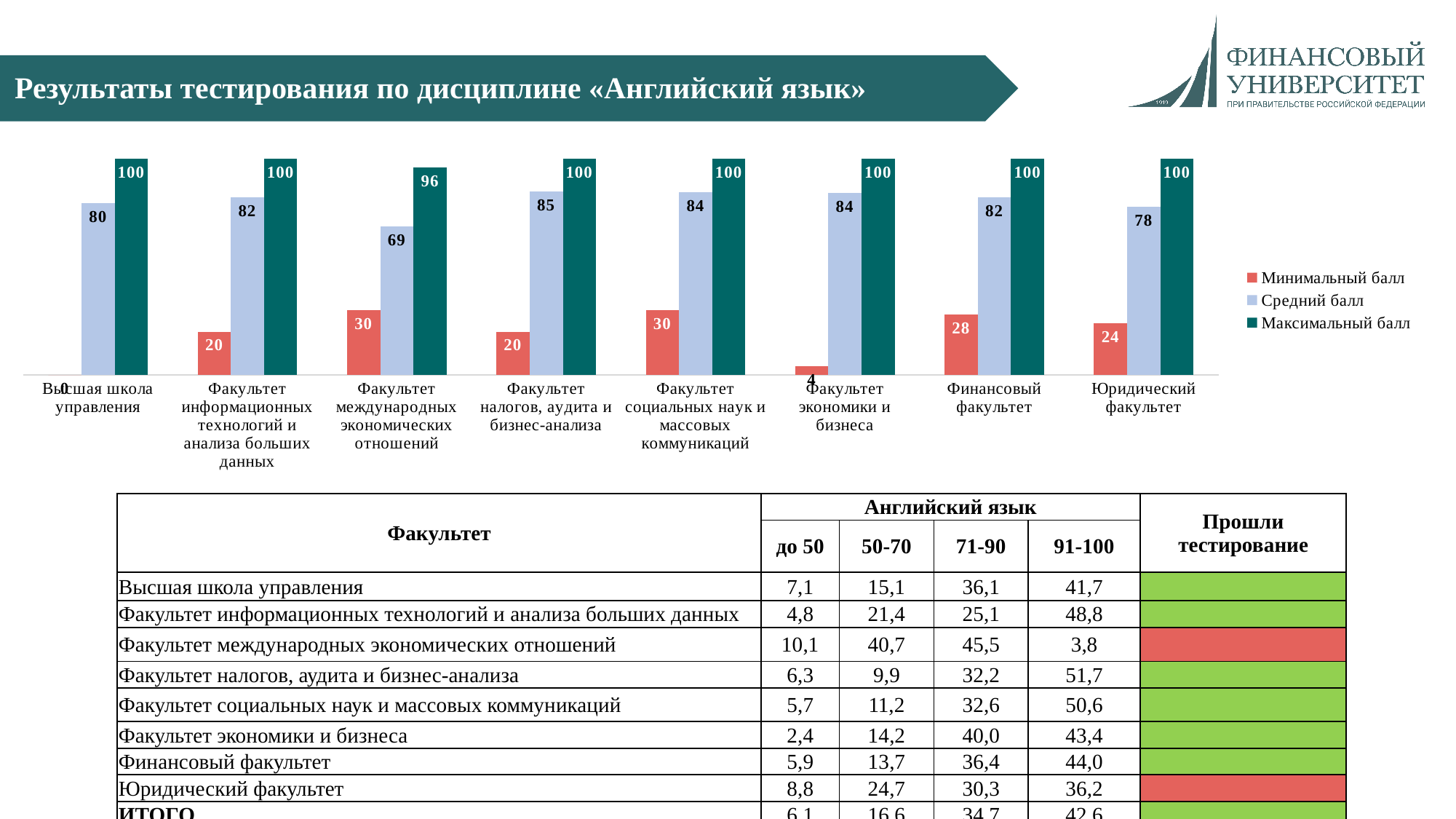
Which colour represents Максимальный балл in the chart legend? dark teal (green) Which faculty has the lowest Средний балл? Факультет международных экономических отношений Which faculty has the highest Средний балл? Факультет налогов, аудита и бизнес-анализа How many series does the chart legend list? 3 Which is larger: the Минимальный балл for Факультет социальных наук и массовых коммуникаций or for Юридический факультет? Факультет социальных наук и массовых коммуникаций What type of chart is shown on the slide? bar chart What is the Минимальный балл for Факультет экономики и бизнеса? 4 What is the Минимальный балл for Финансовый факультет? 28 How many faculties (categories) are shown on the chart's x axis? 8 What is the difference between the Средний балл of Факультет информационных технологий и анализа больших данных and Юридический факультет? 4 What is the Максимальный балл for Факультет международных экономических отношений? 96 What is the Средний балл for Факультет налогов, аудита и бизнес-анализа? 85